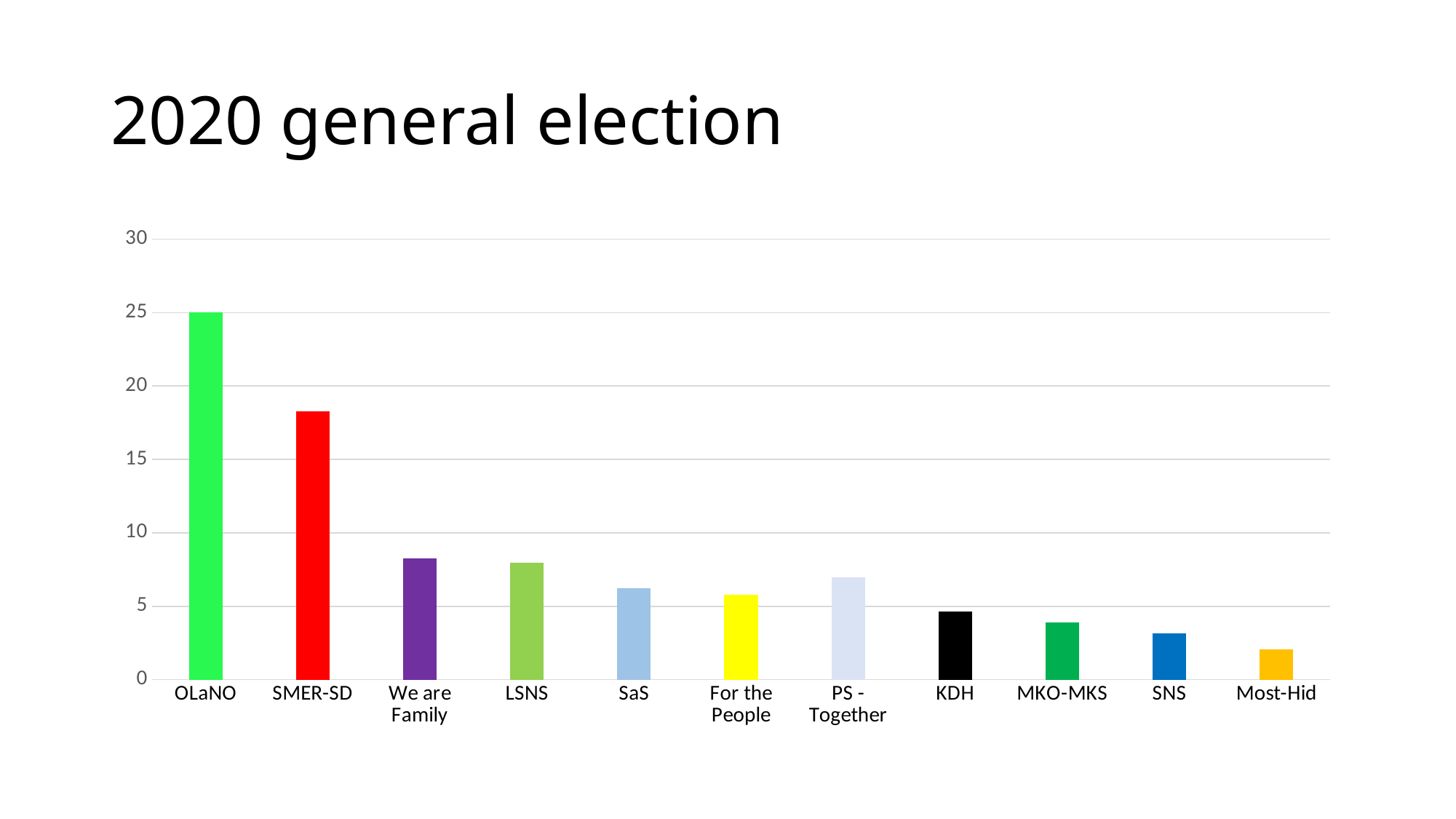
Is the value for LSNS greater or less than 10? less Which party has the lowest bar on the chart? Most-Hid What colour is the bar for OLaNO? green Is the value for SMER-SD greater or less than 15? greater How many parties (categories) are shown on the chart? 11 Do the values generally rise or fall moving from left to right along the x axis? fall Which party has the highest bar on the chart? OLaNO Is the value for KDH greater or less than 5? less What kind of chart is shown on the slide? bar chart What is the value for OLaNO? 25 Which is larger, the value for SMER-SD or the value for We are Family? SMER-SD